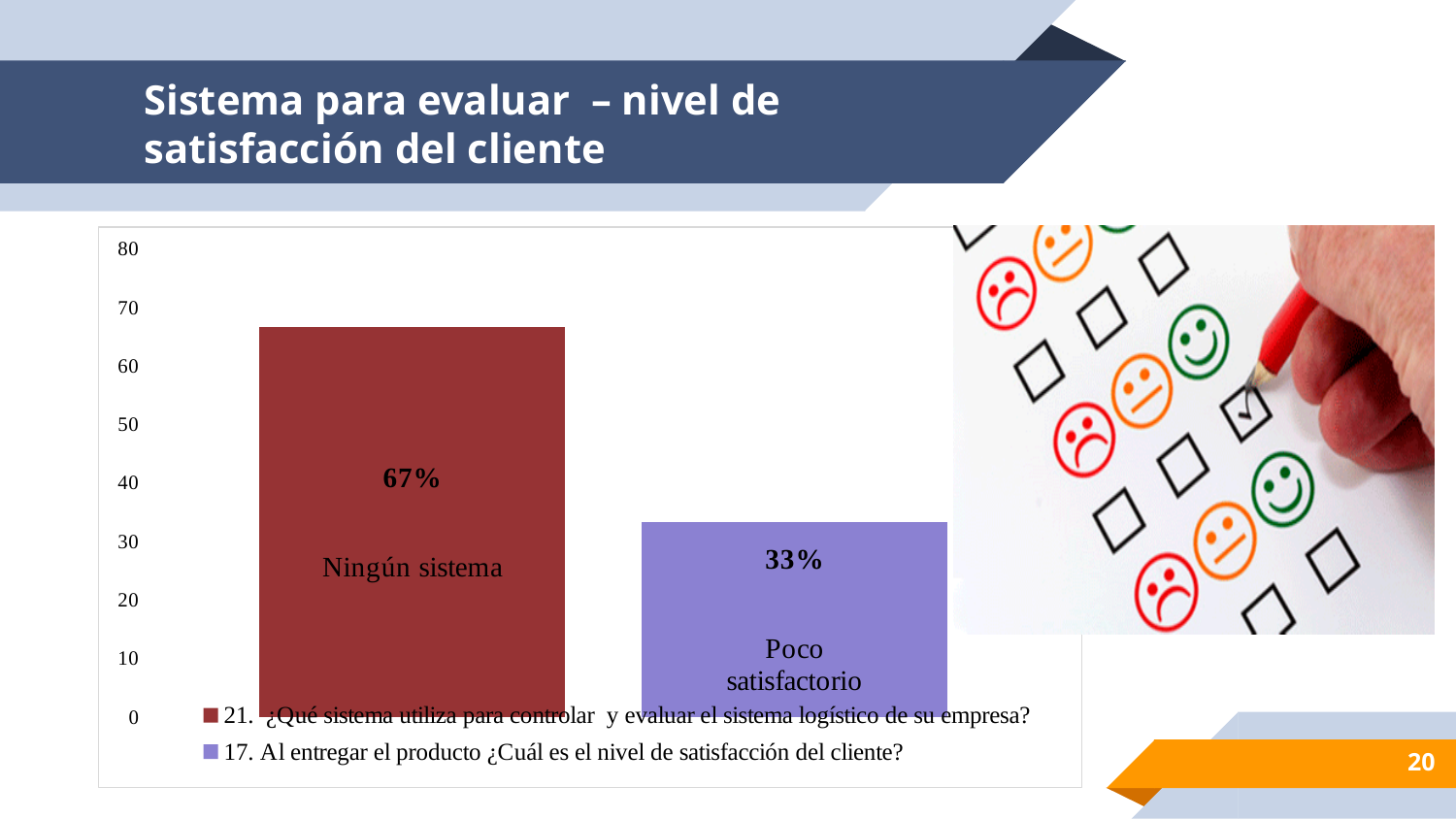
What kind of chart is shown on the slide? Bar chart What colour is the bar labelled "Poco satisfactorio"? Purple How many bars are plotted in the chart? 2 What value is shown on the bar labelled "Ningún sistema"? 67% What is the difference between the values for "Ningún sistema" and "Poco satisfactorio"? 33% Which bar has the lowest value? Poco satisfactorio Which is larger, the value for "Ningún sistema" or the value for "Poco satisfactorio"? Ningún sistema Which bar has the highest value? Ningún sistema Is the value for "Ningún sistema" greater or less than 60? greater What value is shown on the bar labelled "Poco satisfactorio"? 33% How many series does the legend list? 2 Is the value for "Poco satisfactorio" greater or less than 40? less